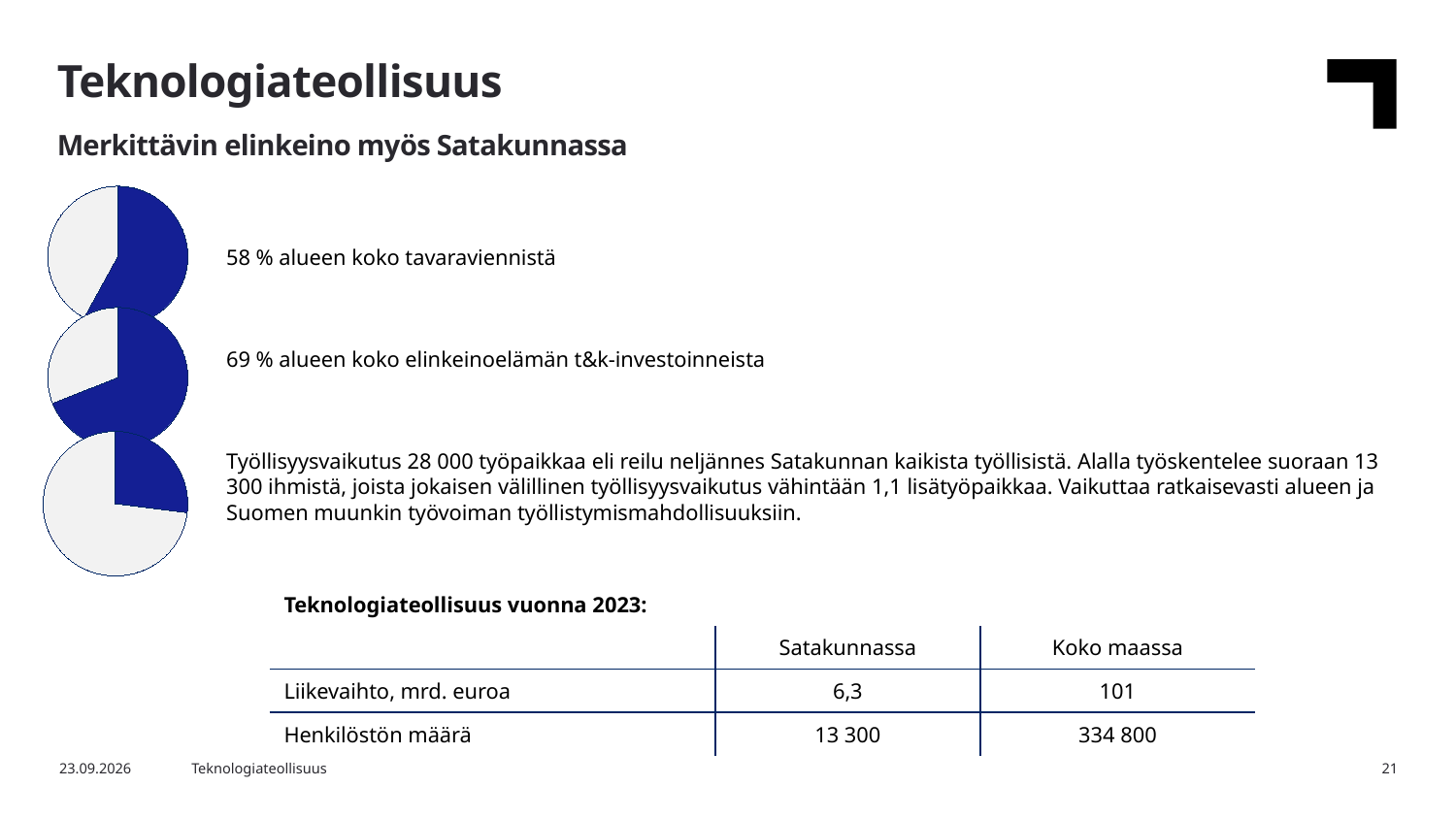
Which of the three pie charts has the smallest blue slice? the bottom one Which of the three pie charts has the largest blue slice? the middle one How many slices does each pie chart on the slide have? 2 What colour is the highlighted slice in each pie chart? blue For the top pie chart, what share of the region's total goods exports does the blue slice represent, according to the text beside it? 58 % Is the blue slice in the bottom pie chart greater or less than half of the pie? less Is the blue slice in the middle pie chart greater or less than half of the pie? greater What is the difference in percentage points between the shares shown for the middle pie chart (69 %) and the top pie chart (58 %)? 11 percentage points For the middle pie chart, what share of the region's business R&D investments does the blue slice represent, according to the text beside it? 69 % Which pie chart has the larger blue slice, the top one or the middle one? the middle one What kind of chart is the top chart on the left side of the slide? pie chart How many pie charts are shown on the slide? 3